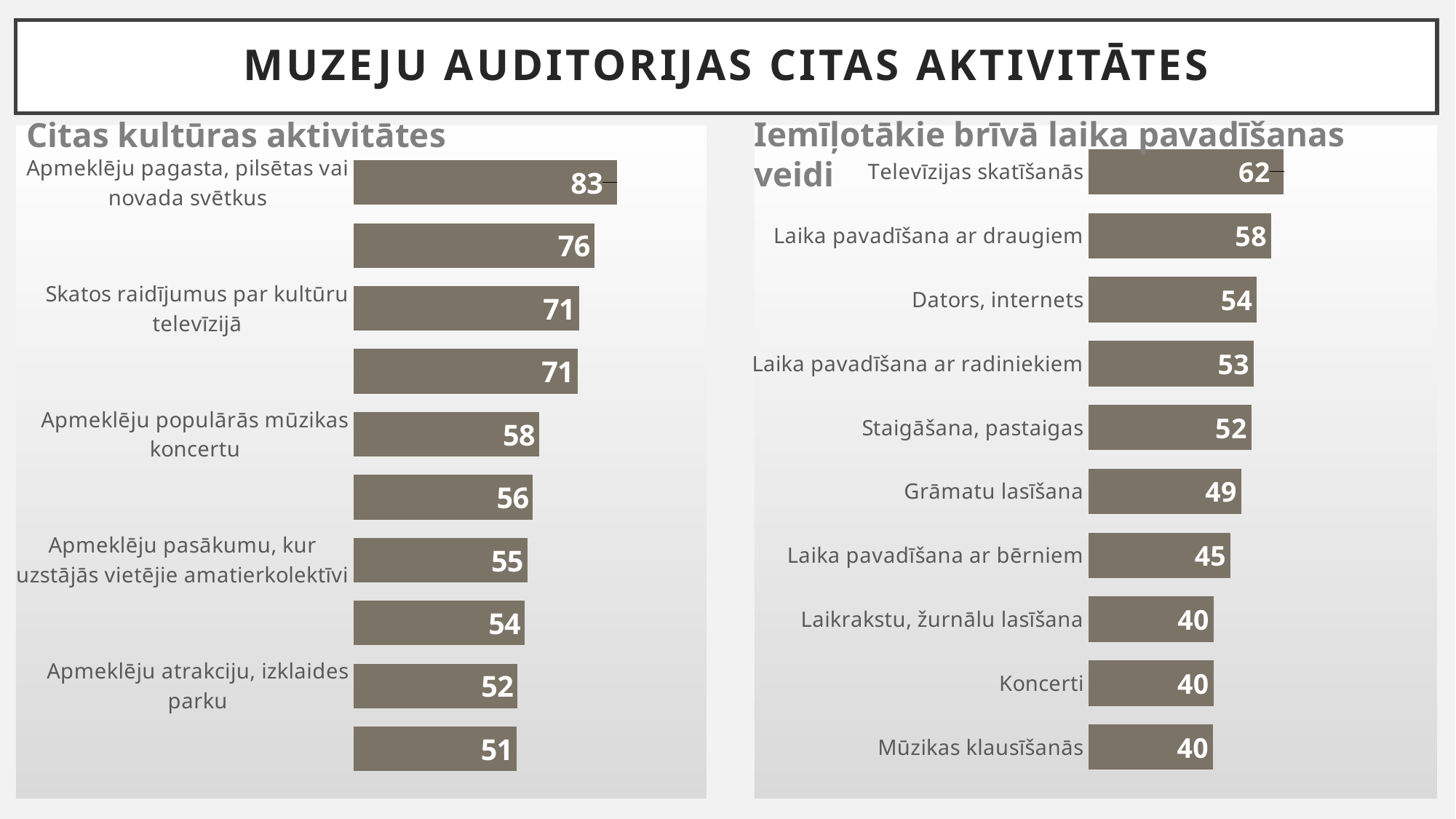
In the chart 'Iemīļotākie brīvā laika pavadīšanas veidi', what is the value for 'Dators, internets'? 54 In the chart 'Citas kultūras aktivitātes', what is the difference between 'Apmeklēju populārās mūzikas koncertu' and 'Apmeklēju pasākumu, kur uzstājās vietējie amatierkolektīvi'? 3 In the chart 'Iemīļotākie brīvā laika pavadīšanas veidi', what is the difference between 'Televīzijas skatīšanās' and 'Koncerti'? 22 What type of chart is 'Iemīļotākie brīvā laika pavadīšanas veidi'? Bar chart In the chart 'Citas kultūras aktivitātes', what is the value for 'Apmeklēju atrakciju, izklaides parku'? 52 In the chart 'Citas kultūras aktivitātes', how many bars are plotted? 10 In the chart 'Iemīļotākie brīvā laika pavadīšanas veidi', which category has the highest value? Televīzijas skatīšanās In the chart 'Iemīļotākie brīvā laika pavadīšanas veidi', which is larger: 'Laika pavadīšana ar draugiem' or 'Laika pavadīšana ar bērniem'? Laika pavadīšana ar draugiem In the chart 'Citas kultūras aktivitātes', what is the value for 'Apmeklēju pagasta, pilsētas vai novada svētkus'? 83 In the chart 'Citas kultūras aktivitātes', which category has the highest value? Apmeklēju pagasta, pilsētas vai novada svētkus In the chart 'Iemīļotākie brīvā laika pavadīšanas veidi', what is the value for 'Grāmatu lasīšana'? 49 In the chart 'Citas kultūras aktivitātes', what is the value for 'Skatos raidījumus par kultūru televīzijā'? 71